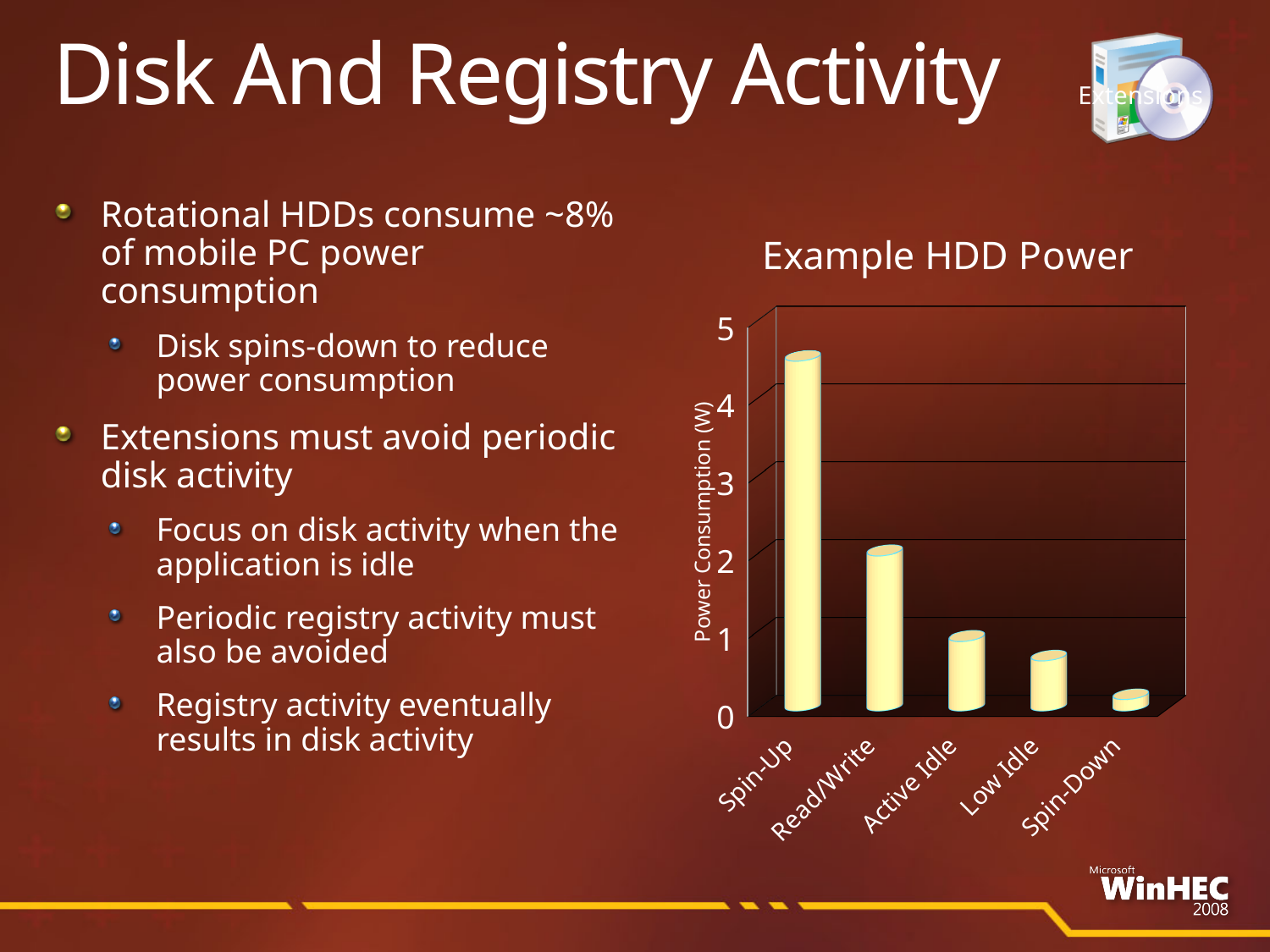
Which category has the highest power consumption? Spin-Up What kind of chart is shown on the slide? bar chart Do the values rise or fall moving from Spin-Up to Spin-Down along the x axis? fall What is the label on the vertical axis of the chart? Power Consumption (W) Is the value for Read/Write greater or less than 3? less Which is larger, the value for Read/Write or the value for Active Idle? Read/Write Is the value for Spin-Down greater or less than 1? less Is the value for Spin-Up greater or less than 4? greater What is the title of the chart? Example HDD Power Which category has the lowest power consumption? Spin-Down How many categories are plotted in the chart? 5